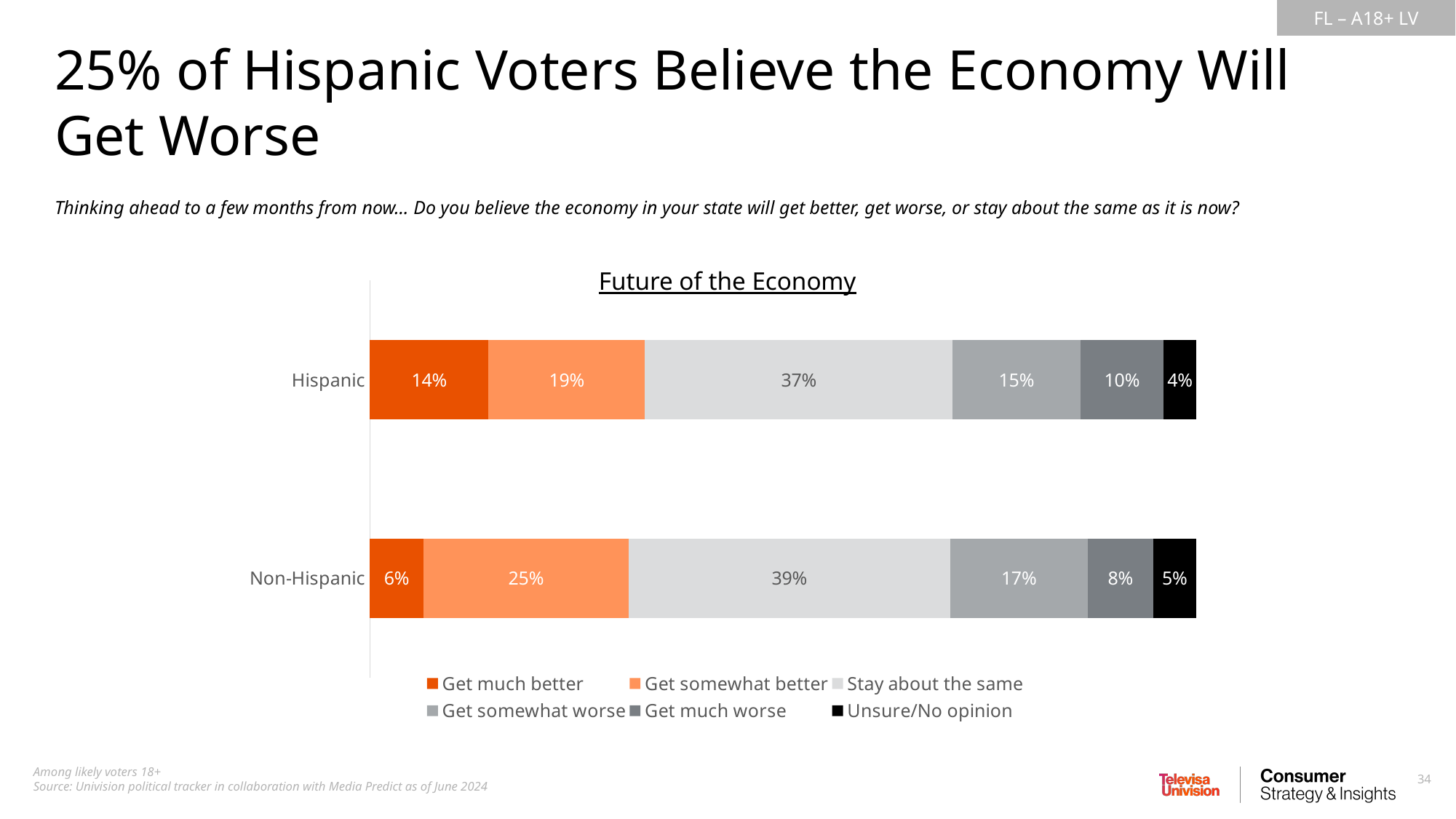
What is the title of the chart? Future of the Economy What is the difference between the Hispanic and Non-Hispanic percentages for 'Get much better'? 8 percentage points Which response category has the smallest share among Non-Hispanic voters? Unsure/No opinion How many groups (bars) are shown in the chart? 2 What type of chart is shown on the slide? Stacked bar chart What percentage of Hispanic voters say the economy will stay about the same? 37% Which response category has the largest share among Hispanic voters? Stay about the same What percentage of Non-Hispanic voters say the economy will get somewhat better? 25% What percentage of Non-Hispanic voters say the economy will get much better? 6% How many series does the legend list? 6 Which group has a higher percentage for 'Get somewhat worse', Hispanic or Non-Hispanic? Non-Hispanic What percentage of Hispanic voters say the economy will get much worse? 10%